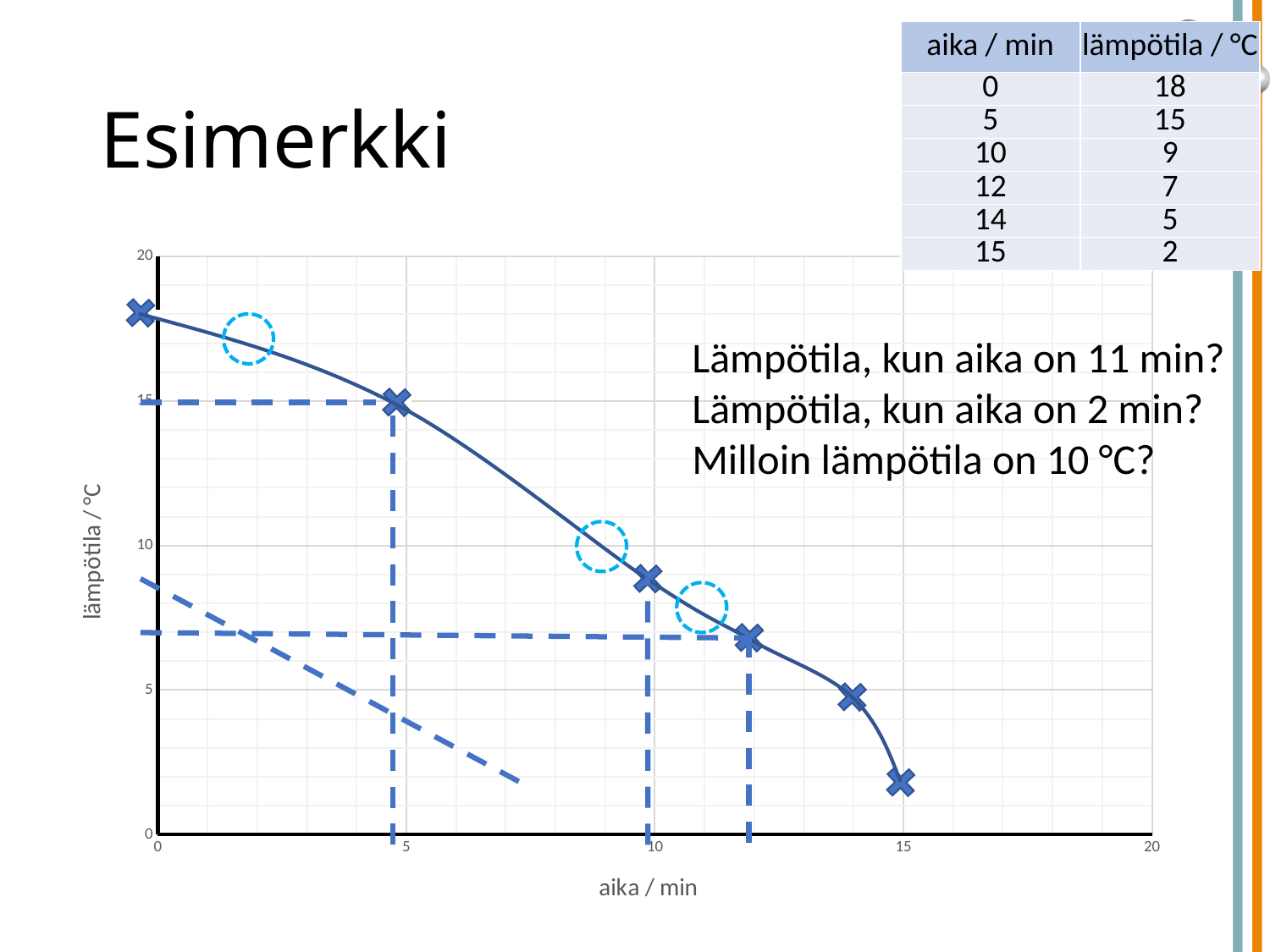
Is the temperature at 14 min greater or less than 10? less What is the temperature when the time is 10 min? 9 What kind of chart is shown on the slide? scatter chart with a smoothed line How many data points are plotted on the chart? 6 What is the temperature when the time is 15 min? 2 At which time is the temperature highest? 0 min At which time is the temperature lowest? 15 min Which is higher, the temperature at 5 min or at 12 min? 5 min Do the temperature values rise or fall as time increases along the x axis? fall What is the difference between the temperature at 0 min and at 15 min? 16 What is the label of the x axis of the chart? aika / min What is the temperature (lämpötila) when the time (aika) is 0 min? 18